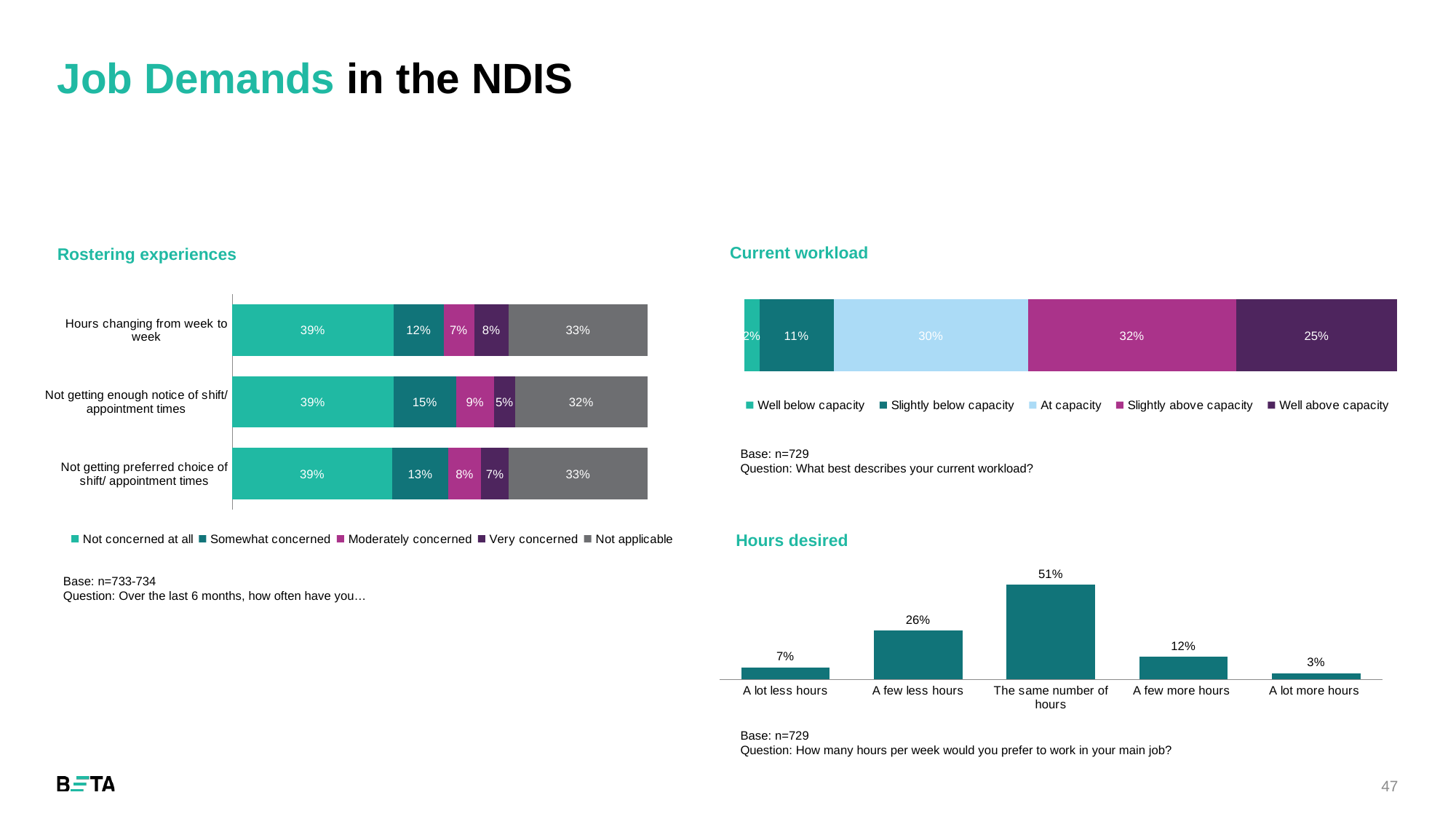
In the Rostering experiences chart, what percentage were 'Very concerned' about not getting preferred choice of shift/appointment times? 7% In the Hours desired chart, how many categories are shown on the x axis? 5 What kind of chart is the Hours desired chart? Bar chart In the Rostering experiences chart, how many series does the legend list? 5 In the Hours desired chart, what percentage want 'A few more hours'? 12% In the Current workload chart, which category has the highest percentage? Slightly above capacity In the Rostering experiences chart, what percentage were 'Not applicable' for hours changing from week to week? 33% In the Rostering experiences chart, what is the difference between the 'Moderately concerned' values for 'Not getting enough notice of shift/appointment times' and 'Hours changing from week to week'? 2% In the Hours desired chart, which category has the highest value? The same number of hours In the Current workload chart, what percentage are 'At capacity'? 30% In the Rostering experiences chart, what percentage were 'Somewhat concerned' about not getting enough notice of shift/appointment times? 15% In the Current workload chart, which category has the lowest percentage? Well below capacity